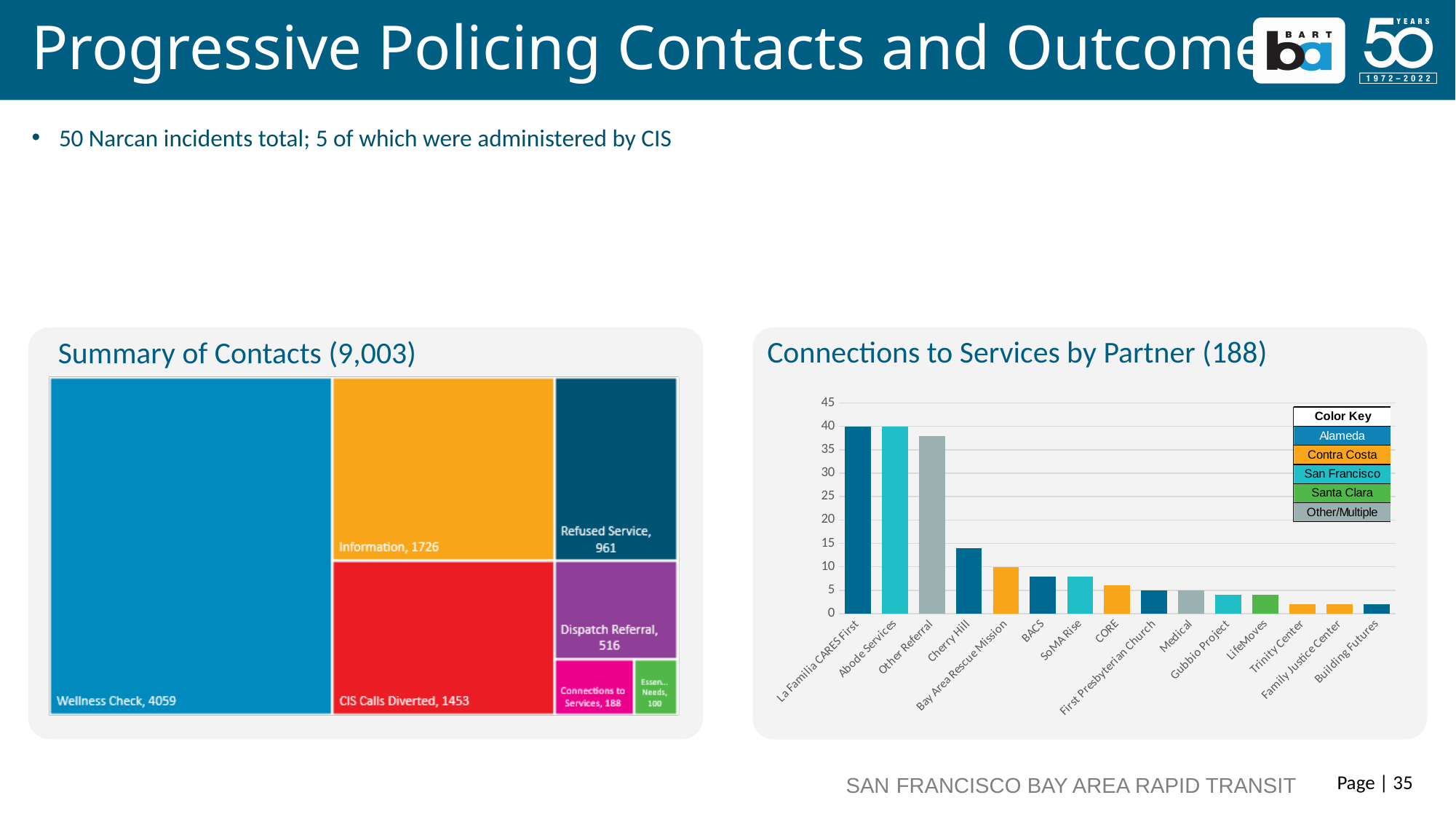
In the Summary of Contacts chart, which is larger: Refused Service or Dispatch Referral? Refused Service In the Summary of Contacts chart, what is the value for Dispatch Referral? 516 In the Summary of Contacts chart, what is the value for Wellness Check? 4059 In the Connections to Services by Partner chart, is the value for Cherry Hill greater or less than 10? greater How many entries does the Color Key list in the Connections to Services by Partner chart? 5 How many partner categories are shown in the Connections to Services by Partner chart? 15 In the Summary of Contacts chart, what is the difference between Information and CIS Calls Diverted? 273 In the Summary of Contacts chart, which category has the highest value? Wellness Check In the Connections to Services by Partner chart, is the value for Other Referral greater or less than 35? greater What kind of chart is the Connections to Services by Partner chart? bar chart In the Summary of Contacts chart, what is the value for Information? 1726 In the Summary of Contacts chart, what is the difference between Refused Service and Connections to Services? 773